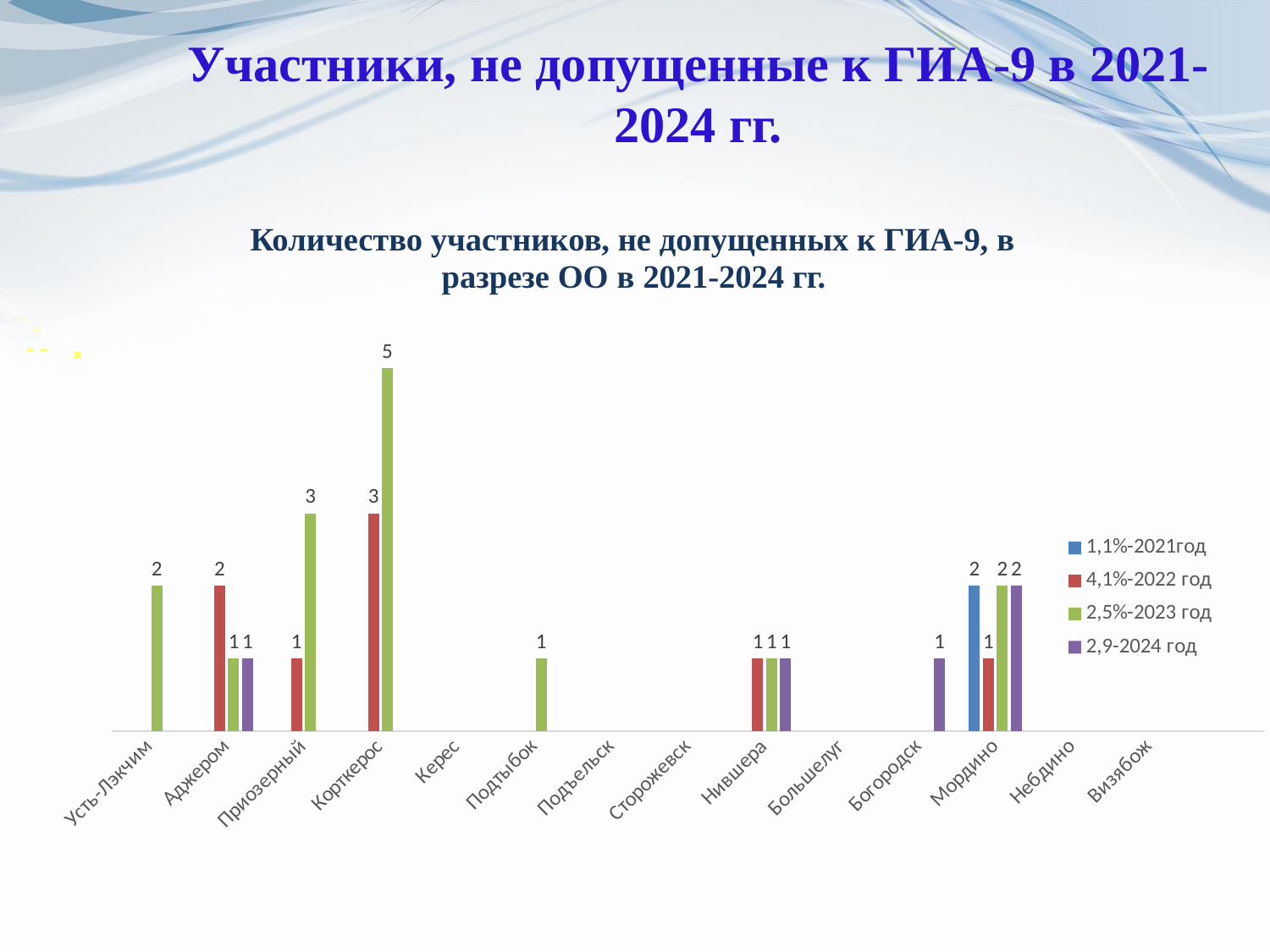
Which category has the highest value in the 2,5%-2023 год series? Корткерос What is the difference between the 2,5%-2023 год and 4,1%-2022 год values for Корткерос? 2 What is the value for Мордино in the 1,1%-2021год series? 2 What type of chart is shown on the slide? bar chart What is the value for Корткерос in the 4,1%-2022 год series? 3 Which category is the only one with a bar in the 1,1%-2021год series? Мордино How many series does the legend list? 4 What is the value for Корткерос in the 2,5%-2023 год series? 5 How many categories (schools) are shown on the x axis? 14 What is the value for Приозерный in the 2,5%-2023 год series? 3 What is the value for Аджером in the 4,1%-2022 год series? 2 Which is larger for Приозерный: the 4,1%-2022 год value or the 2,5%-2023 год value? 2,5%-2023 год